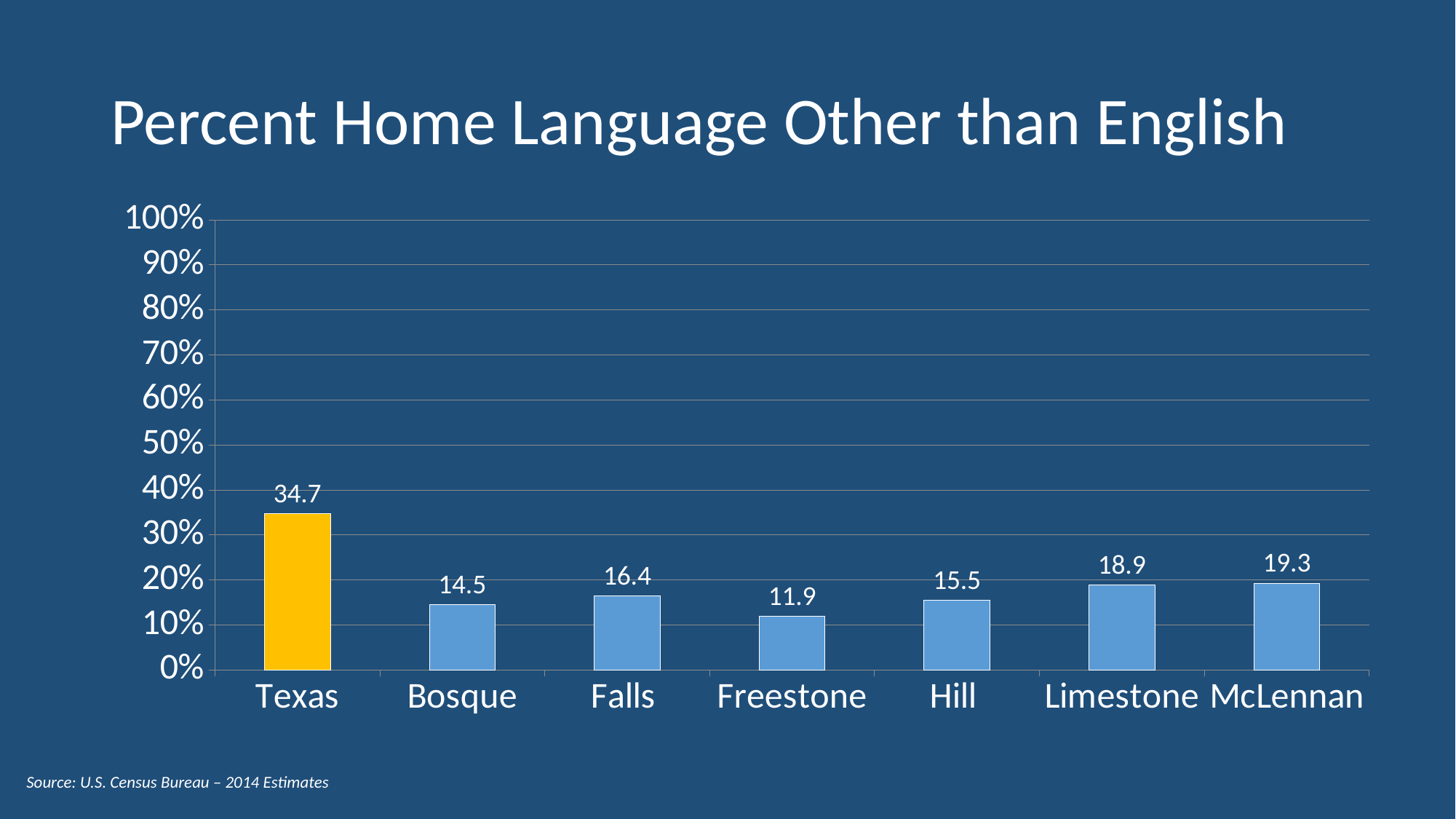
How many categories are shown on the x axis? 7 Which category has the lowest value? Freestone What is the difference between the values for Falls and Bosque? 1.9 What is the value shown for Texas? 34.7 Which bar is coloured differently from the others? Texas Which is larger, the value for Hill or the value for Limestone? Limestone What is the value shown for Limestone? 18.9 Which category has the highest value? Texas What is the difference between the values for Texas and McLennan? 15.4 What is the value shown for Freestone? 11.9 What kind of chart is shown on the slide? bar chart Is the value for Texas greater or less than 30%? greater